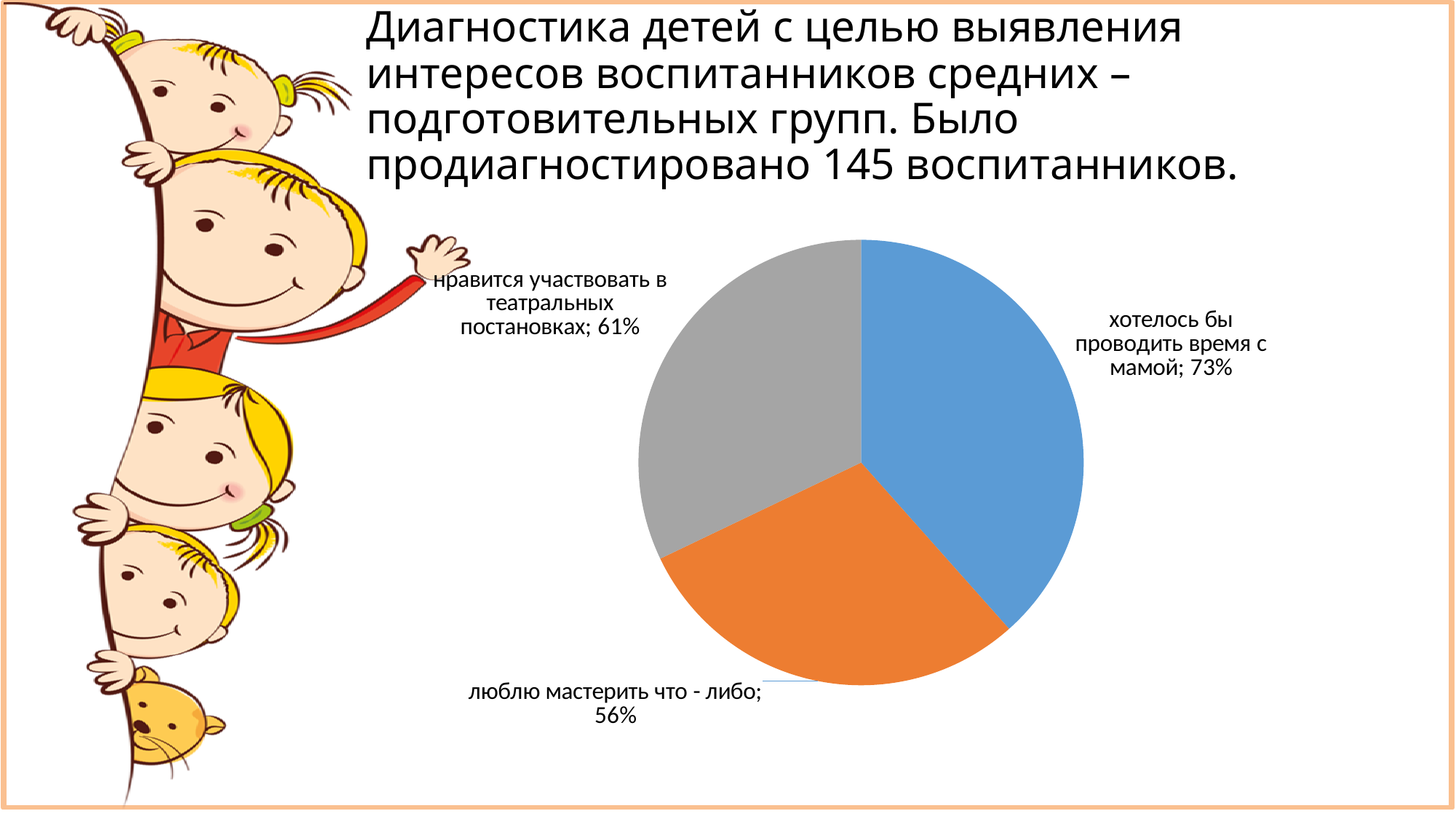
What value is shown for the slice "люблю мастерить что - либо"? 56% How many slices does the pie chart have? 3 According to the slide title, how many children were diagnosed? 145 What kind of chart is shown on the slide? pie chart What is the difference between the values for "хотелось бы проводить время с мамой" and "люблю мастерить что - либо"? 17% What value is shown for the slice "хотелось бы проводить время с мамой"? 73% Which is larger: the value for "хотелось бы проводить время с мамой" or for "нравится участвовать в театральных постановках"? хотелось бы проводить время с мамой What colour is the slice for "люблю мастерить что - либо"? orange Which category has the lowest value in the pie chart? люблю мастерить что - либо What value is shown for the slice "нравится участвовать в театральных постановках"? 61% Which category has the highest value in the pie chart? хотелось бы проводить время с мамой What is the difference between the values for "нравится участвовать в театральных постановках" and "люблю мастерить что - либо"? 5%